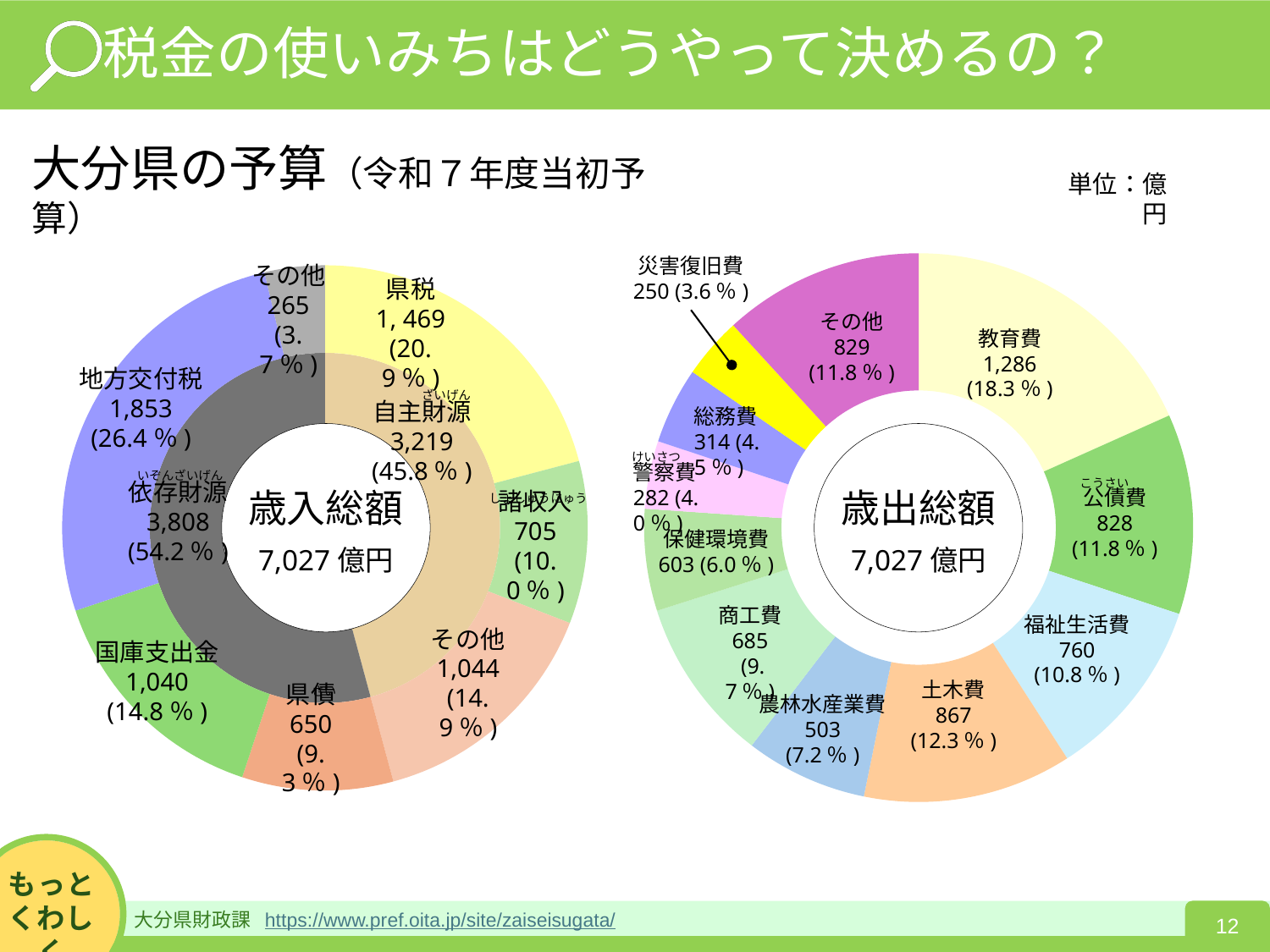
What total is shown in the centre of the 歳出総額 chart on the right? 7,027 億円 In the 歳出総額 chart on the right, which category has the lowest value? 災害復旧費 In the 歳出総額 chart on the right, what is the value for 土木費? 867 In the 歳出総額 chart on the right, which category has the highest value? 教育費 In the 歳入総額 chart on the left, what is the difference between 地方交付税 and 県税? 384 How many categories are shown in the 歳出総額 chart on the right? 11 In the 歳入総額 chart on the left, what share of the total is 県税? 20.9% In the 歳入総額 chart on the left, which of 国庫支出金 or 県債 is larger? 国庫支出金 In the 歳出総額 chart on the right, what share of the total is 福祉生活費? 10.8% In the 歳入総額 chart on the left, what is the value for 地方交付税? 1,853 In the 歳入総額 chart on the left, what is the value for 依存財源 in the inner ring? 3,808 What type of chart is the 歳入総額 chart on the left? Pie (donut) chart